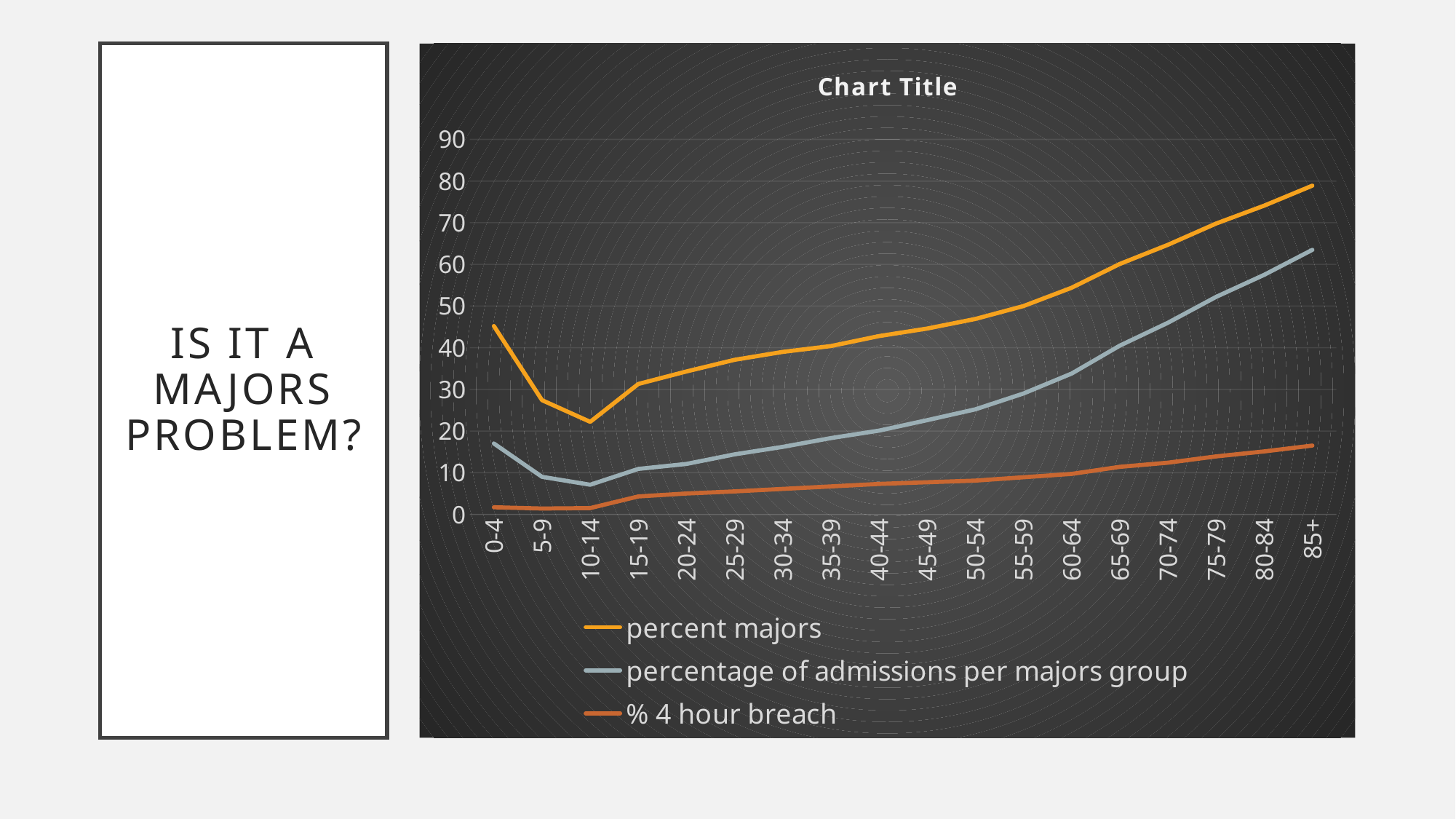
What is the title shown on the chart? Chart Title How many age-group categories are shown on the x axis? 18 Is the value for percent majors at 10-14 greater or less than 30? less Is the value for percentage of admissions per majors group at 85+ greater or less than 60? greater Is the value for percent majors at 85+ greater or less than 70? greater Which age group has the lowest value for percentage of admissions per majors group? 10-14 Which age group has the highest value for percent majors? 85+ What kind of chart is shown on the slide? line chart Which age group has the lowest value for percent majors? 10-14 At 85+, which is larger: percent majors or percentage of admissions per majors group? percent majors How many series does the legend list? 3 Does the percent majors line rise or fall from 15-19 to 85+? rise